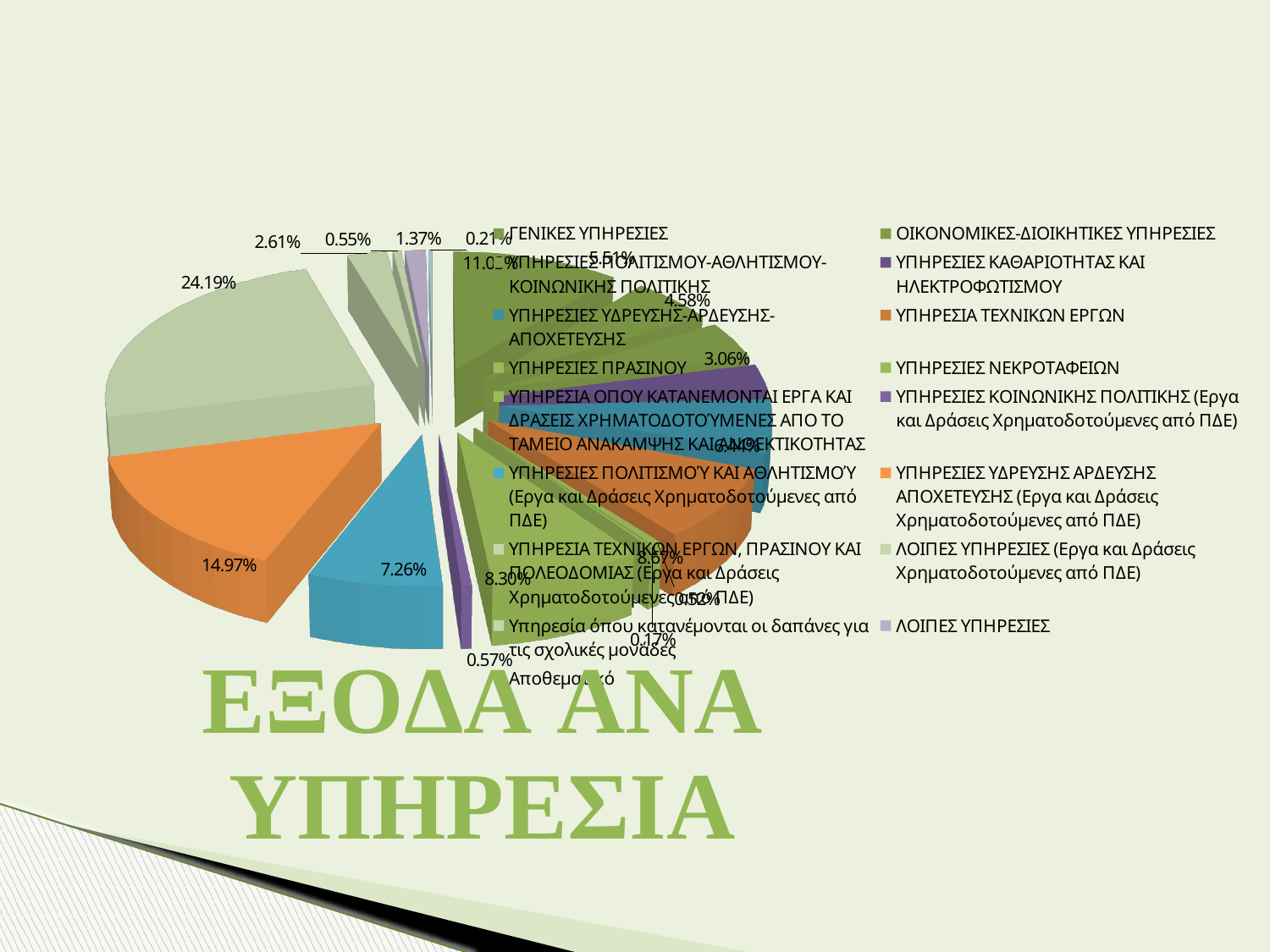
What is the smallest percentage shown as a data label on the pie chart? 0.17% What is the largest percentage shown as a data label on the pie chart? 24.19% What is the first entry listed in the legend of the pie chart? ΓΕΝΙΚΕΣ ΥΠΗΡΕΣΙΕΣ Is the largest slice of the pie chart greater or less than 20%? greater Which is larger, the slice labelled 24.19% or the slice labelled 14.97%? 24.19% What is the difference between the slice labelled 14.97% and the slice labelled 7.26%? 7.71% What percentage is shown on the large orange slice of the pie chart? 14.97% What percentage is shown on the blue slice at the bottom of the pie chart? 7.26% How many entries does the legend of the pie chart list? 17 What is the difference between the slice labelled 24.19% and the slice labelled 14.97%? 9.22% What is the title shown on the slide for this chart? ΕΞΟΔΑ ΑΝΑ ΥΠΗΡΕΣΙΑ What kind of chart is shown on the slide? Pie chart